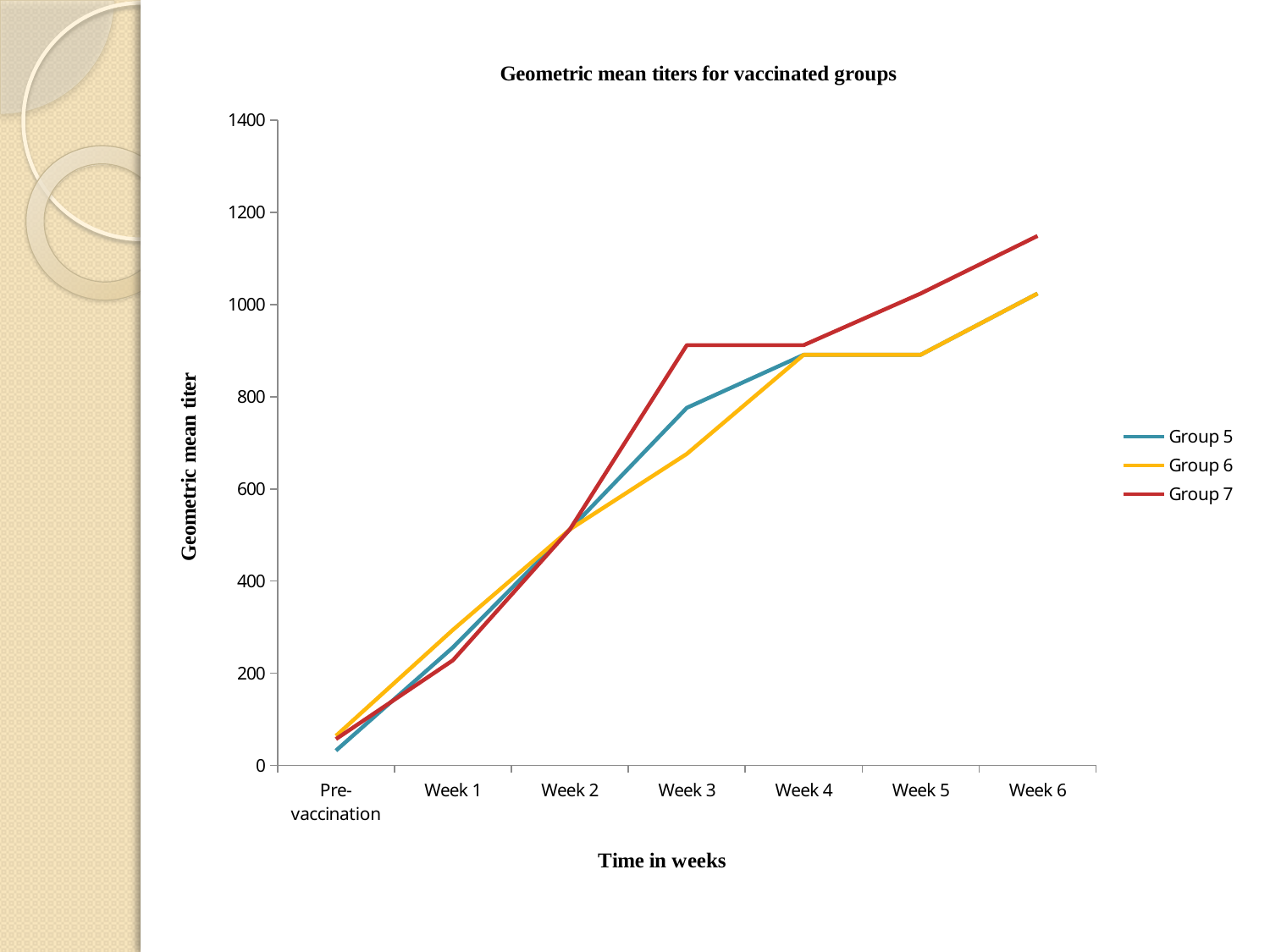
How many time points are shown on the x axis? 7 What is the label of the y axis? Geometric mean titer At Week 3, which is larger: the value for Group 7 or the value for Group 6? Group 7 How many series does the legend list? 3 Which group has the highest value at Week 6? Group 7 Do the values for Group 7 rise or fall from Pre-vaccination to Week 6? rise What kind of chart is shown on the slide? line chart Which group has the lowest value at Week 3? Group 6 Is the value for Group 7 at Pre-vaccination greater or less than 200? less What is the title of the chart? Geometric mean titers for vaccinated groups Is the value for Group 6 at Week 3 greater or less than 800? less Is the value for Group 7 at Week 6 greater or less than 1000? greater